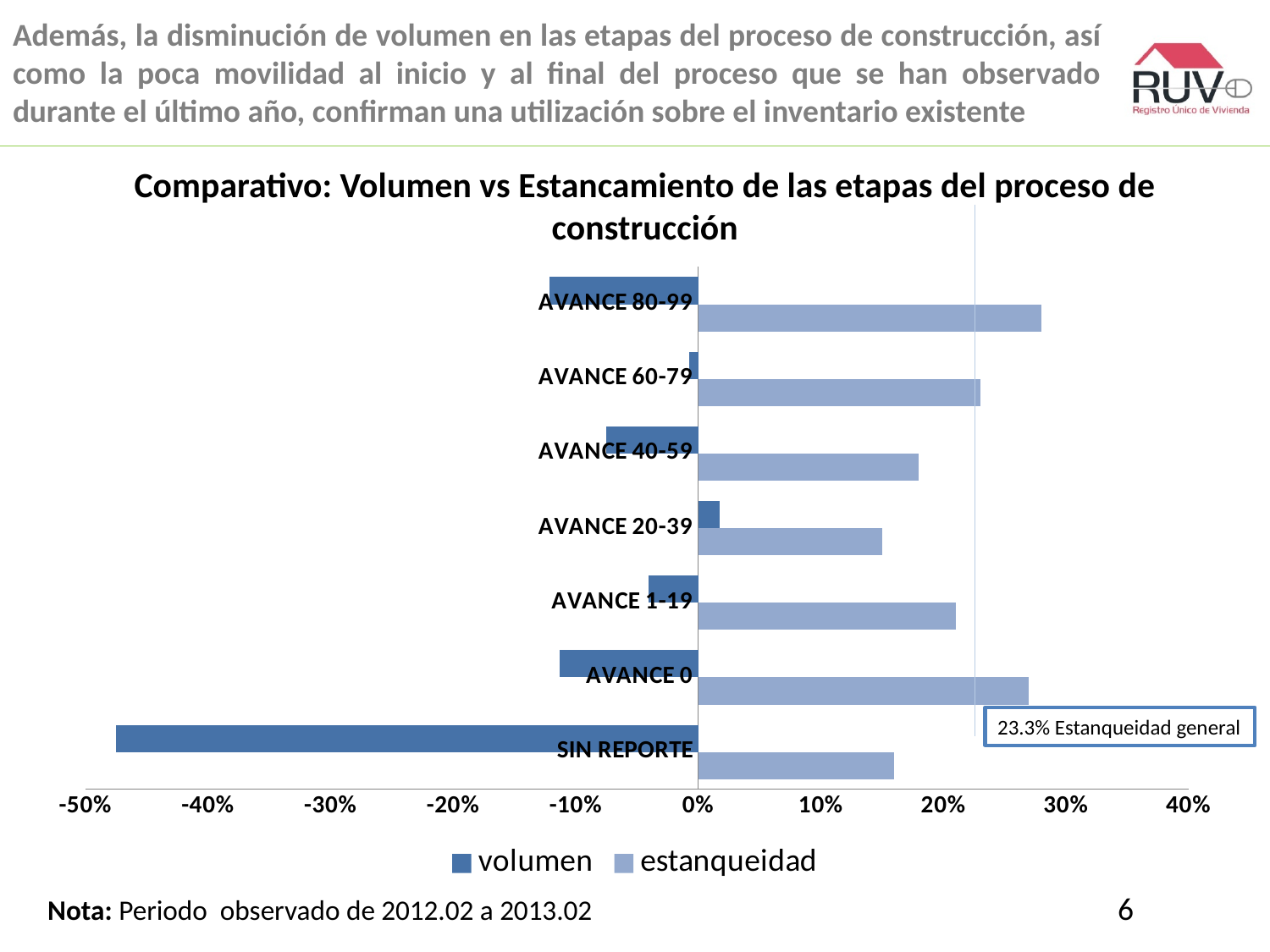
What general estanqueidad value is shown in the annotation box on the chart? 23.3% Is the volumen value for SIN REPORTE greater or less than -40%? less What type of chart is shown on the slide? bar chart Is the estanqueidad value for AVANCE 40-59 greater or less than 20%? less Which has the larger estanqueidad value, AVANCE 60-79 or AVANCE 20-39? AVANCE 60-79 How many series does the legend list? 2 Which category has the lowest value for volumen? SIN REPORTE Which has the larger volumen value, AVANCE 0 or AVANCE 1-19? AVANCE 1-19 How many categories are plotted on the chart? 7 Is the estanqueidad value for AVANCE 0 greater or less than 20%? greater What is the title of the chart? Comparativo: Volumen vs Estancamiento de las etapas del proceso de construcción